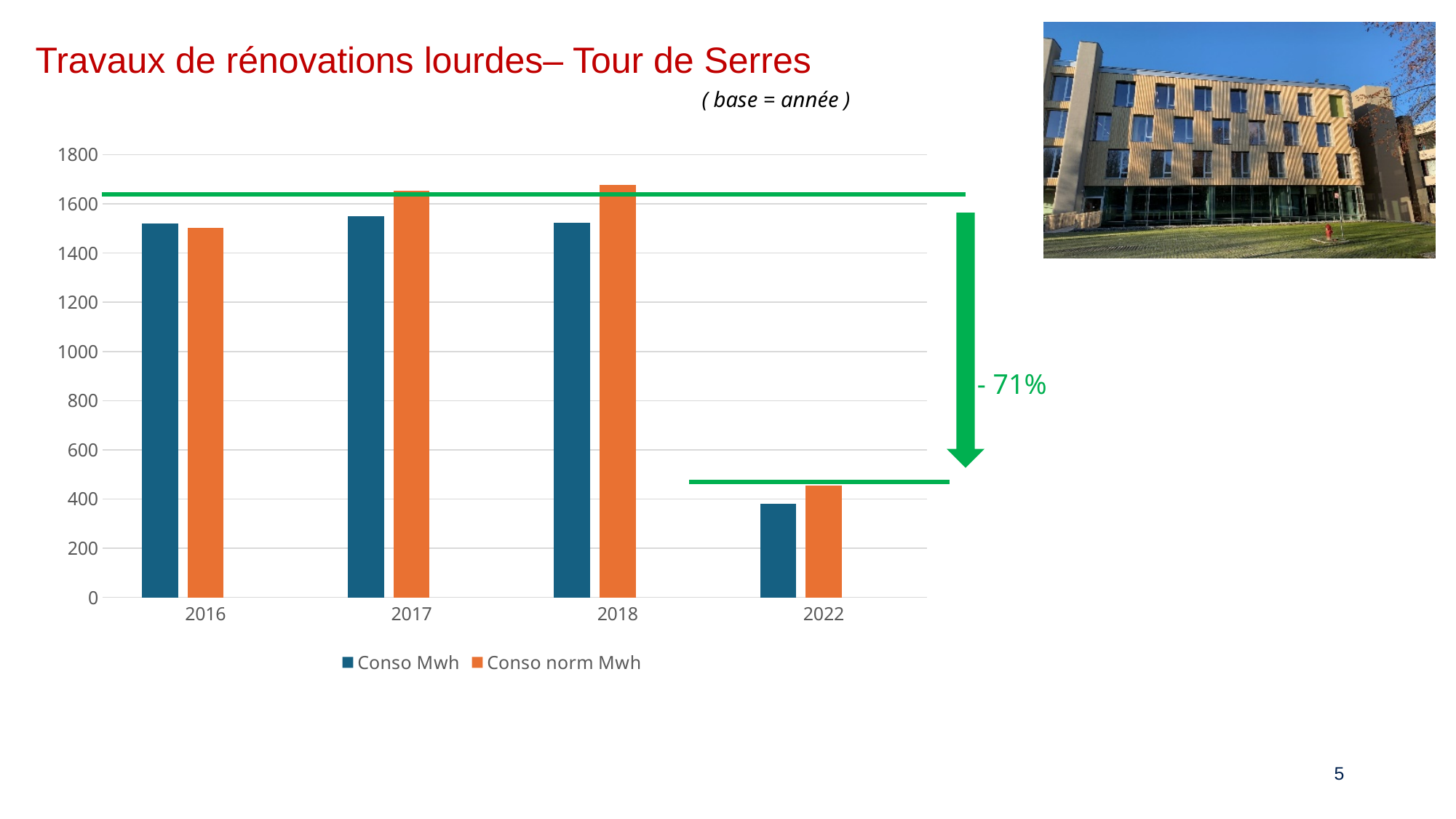
What kind of chart is shown on the slide? bar chart Is the value for Conso norm Mwh in 2022 greater or less than 400? greater Is the value for Conso norm Mwh in 2018 greater or less than 1600? greater In 2018, which is larger: Conso Mwh or Conso norm Mwh? Conso norm Mwh What percentage change is indicated by the green arrow annotation next to the chart? - 71% Is the value for Conso Mwh in 2016 greater or less than 1400? greater How many years are shown on the x axis of the chart? 4 In 2022, which is larger: Conso Mwh or Conso norm Mwh? Conso norm Mwh How many series does the chart legend list? 2 Which year has the lowest value for Conso norm Mwh? 2022 Which year has the lowest value for Conso Mwh? 2022